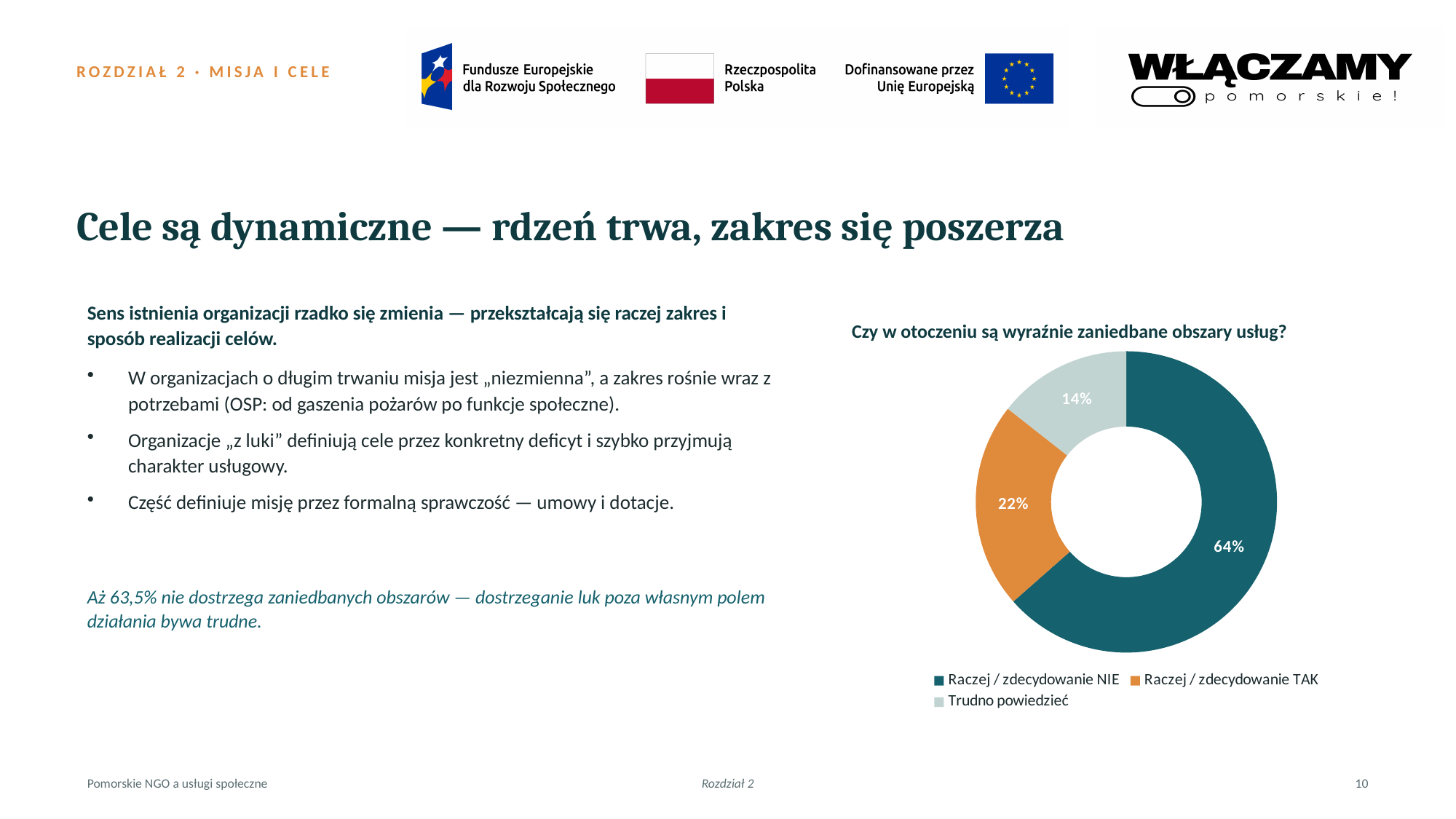
What kind of chart is shown on the slide? Doughnut (pie) chart Which category has the smallest slice in the chart? Trudno powiedzieć What share of the chart is labelled "Raczej / zdecydowanie TAK"? 22% How many categories does the chart show? 3 What is the difference in percentage points between "Raczej / zdecydowanie NIE" and "Raczej / zdecydowanie TAK"? 42 percentage points What colour is the slice for "Raczej / zdecydowanie TAK"? Orange What is the title of the chart on the slide? Czy w otoczeniu są wyraźnie zaniedbane obszary usług? What share of the chart is labelled "Trudno powiedzieć"? 14% How many entries does the chart legend list? 3 Which category has the largest slice in the chart? Raczej / zdecydowanie NIE Which is larger: the slice for "Raczej / zdecydowanie TAK" or the slice for "Trudno powiedzieć"? Raczej / zdecydowanie TAK What share of the chart is labelled "Raczej / zdecydowanie NIE"? 64%